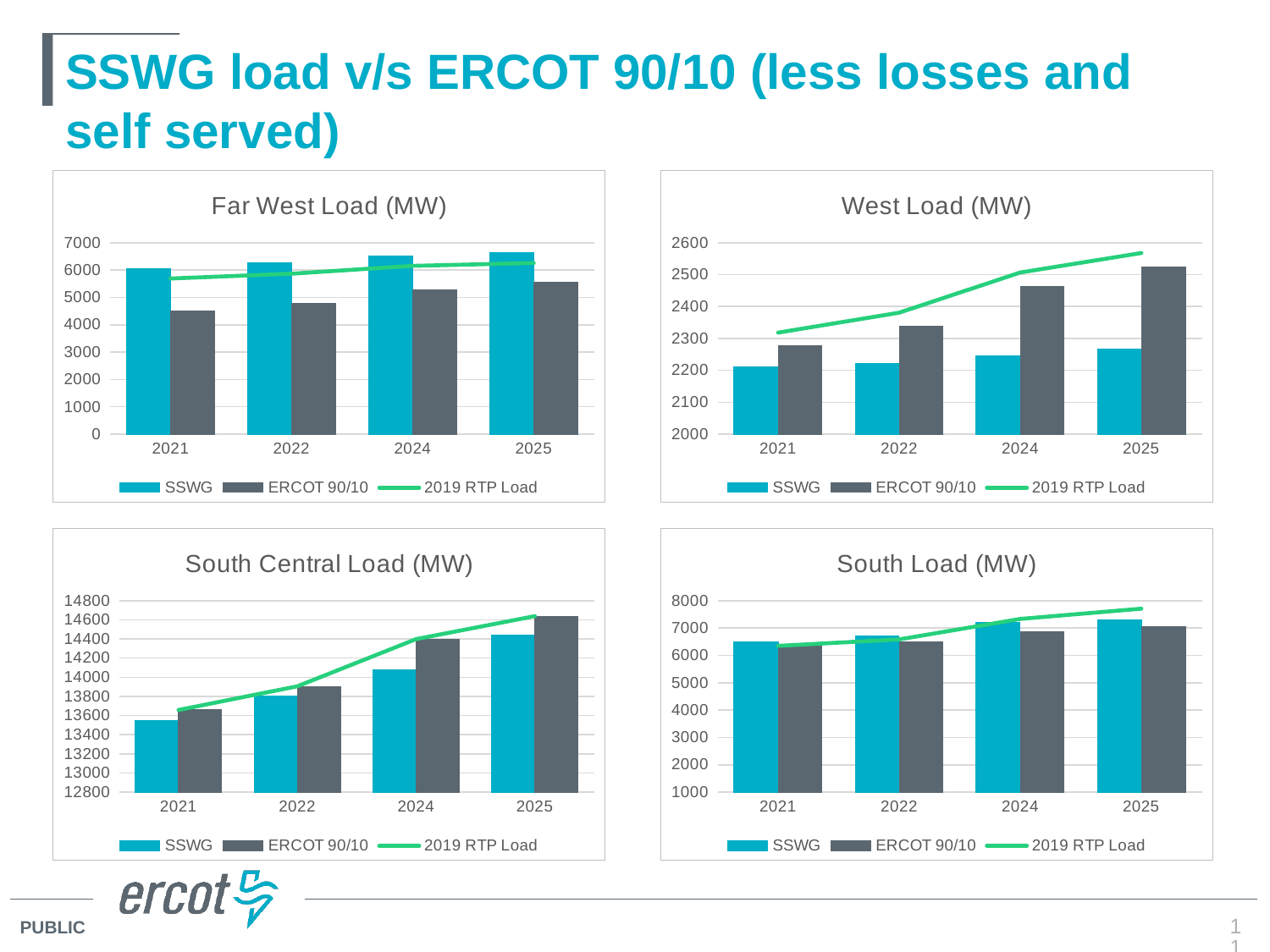
In the South Central Load (MW) chart, is the SSWG value for 2024 greater or less than 14200? less In the South Load (MW) chart, is the SSWG value for 2025 greater or less than 7000? greater In the South Load (MW) chart, in which year is the SSWG value lowest? 2021 In the West Load (MW) chart, in which year is the ERCOT 90/10 value highest? 2025 In the South Central Load (MW) chart, which is larger in 2024, SSWG or ERCOT 90/10? ERCOT 90/10 In the Far West Load (MW) chart, which is larger in 2021, SSWG or ERCOT 90/10? SSWG In the West Load (MW) chart, is the SSWG value for 2025 greater or less than 2300? less In the West Load (MW) chart, does the 2019 RTP Load line rise or fall from 2021 to 2025? rises In the Far West Load (MW) chart, how many years are shown on the x axis? 4 In the Far West Load (MW) chart, what kind of chart is used for the SSWG and ERCOT 90/10 series? bar chart In the Far West Load (MW) chart, how many series does the legend list? 3